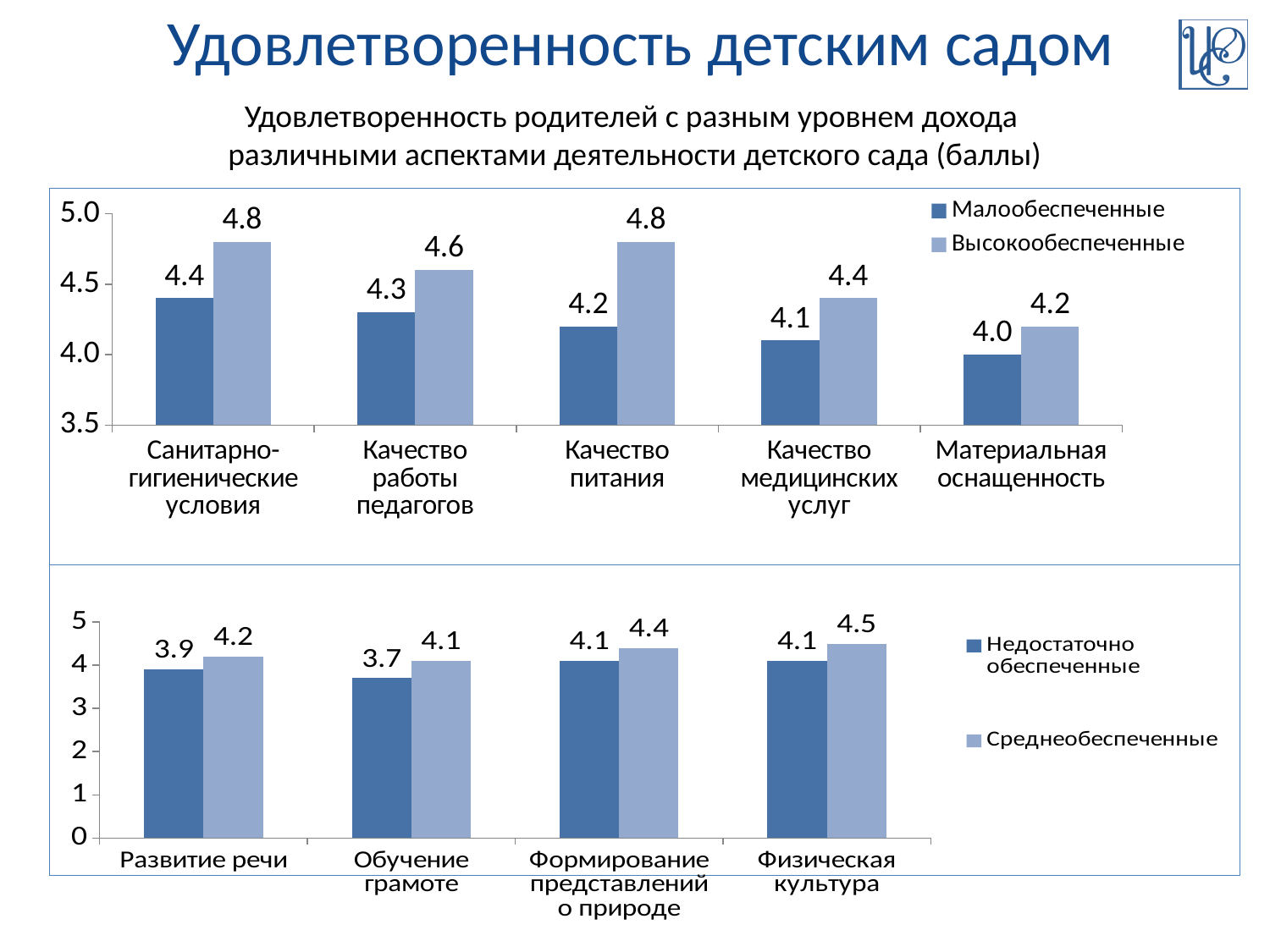
In the top chart, how many categories are shown on the x axis? 5 In the top chart, what is the value for Малообеспеченные for Качество питания? 4.2 What kind of chart is the bottom chart? Bar chart In the top chart, how many series does the legend list? 2 In the top chart, what is the value for Высокообеспеченные for Качество работы педагогов? 4.6 In the top chart, what is the difference between Высокообеспеченные and Малообеспеченные for Качество питания? 0.6 In the bottom chart, which category has the lowest value for Недостаточно обеспеченные? Обучение грамоте In the bottom chart, what is the value for Среднеобеспеченные for Физическая культура? 4.5 In the bottom chart, which is larger for Развитие речи: Недостаточно обеспеченные or Среднеобеспеченные? Среднеобеспеченные In the top chart, which category has the lowest value for Малообеспеченные? Материальная оснащенность In the bottom chart, how many categories are shown on the x axis? 4 In the bottom chart, what is the value for Недостаточно обеспеченные for Обучение грамоте? 3.7